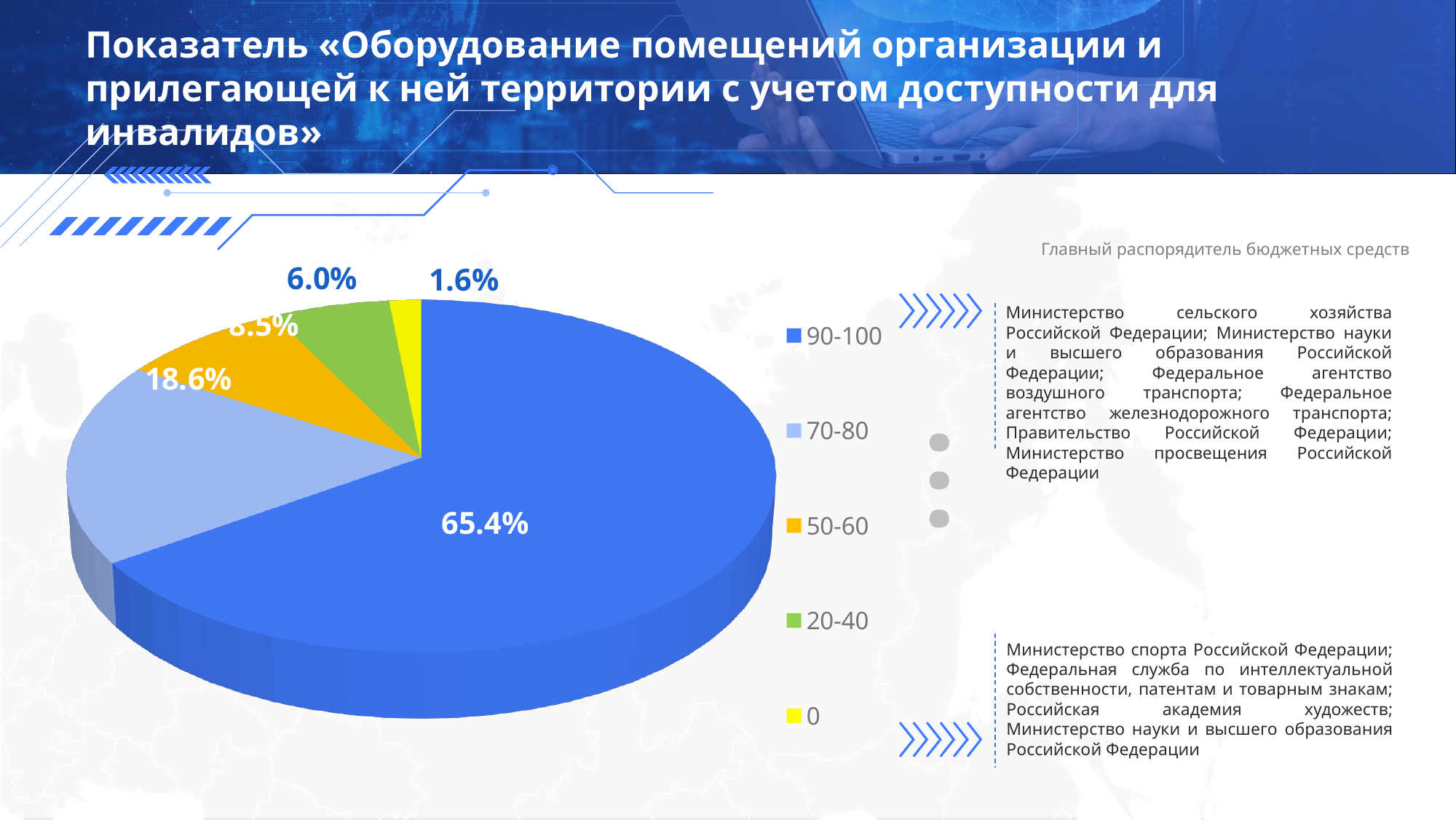
What is the difference between the 20-40 share and the share for 0? 4.4 percentage points What kind of chart is shown on the slide? Pie chart What is the value shown for the 20-40 category? 6.0% What share of the pie does the 90-100 category have? 65.4% What is the value shown for the category labelled 0? 1.6% Which is larger, the 70-80 slice or the 20-40 slice? 70-80 What is the value shown for the 70-80 category? 18.6% What is the difference between the 90-100 share and the 70-80 share? 46.8 percentage points How many categories does the pie chart have? 5 Which category has the largest slice of the pie? 90-100 Which category has the smallest slice of the pie? 0 What colour is the slice for the category labelled 0? Yellow